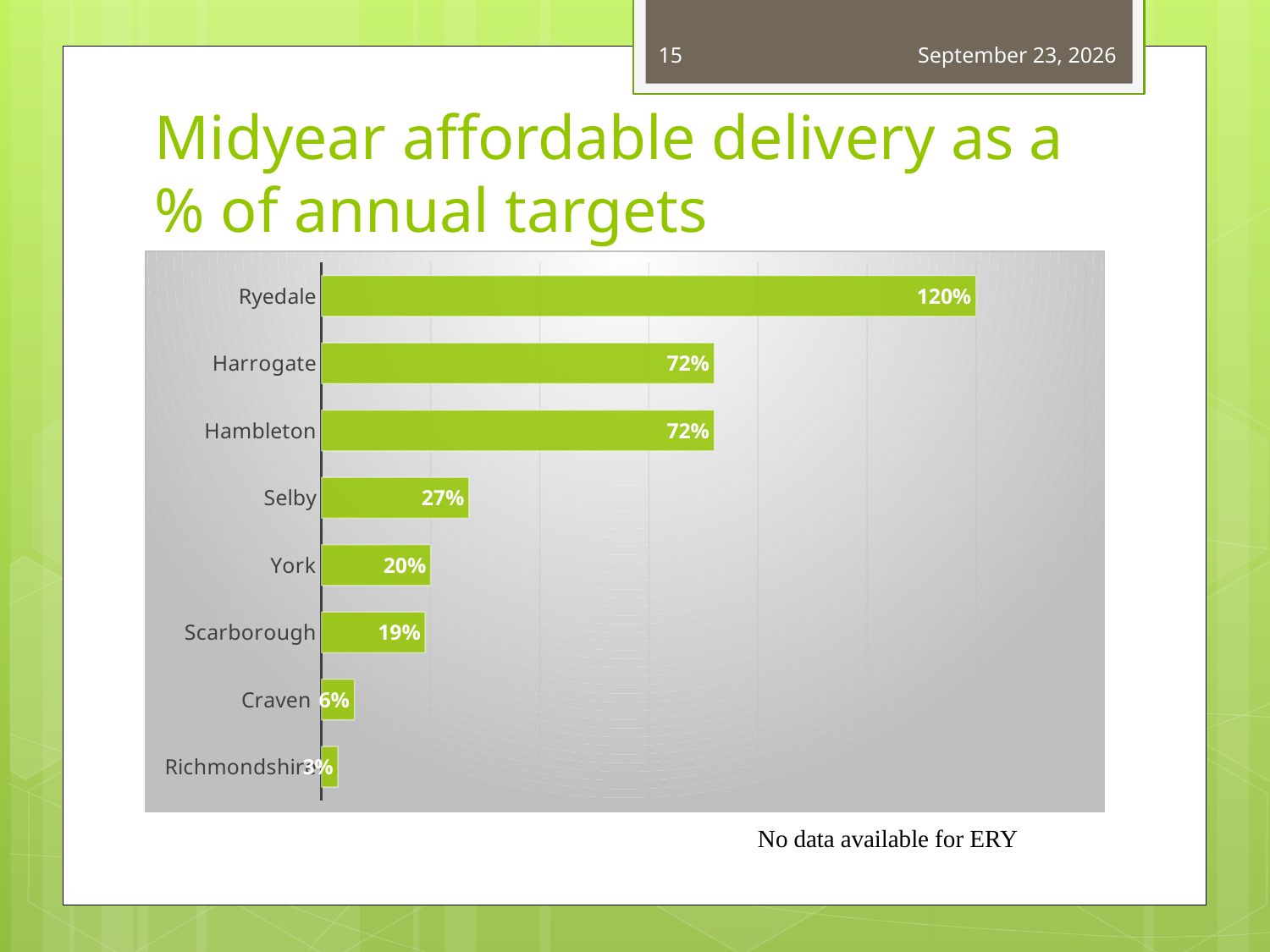
What is the value for Craven? 6% What is the value for Scarborough? 19% What is the value for Ryedale? 120% Which category has the lowest value? Richmondshire Which is larger, the value for Selby or the value for York? Selby Which category has the highest value? Ryedale What kind of chart is shown on the slide? Bar chart What is the value for Selby? 27% What is the difference between the values for Ryedale and Harrogate? 48% What is the title of the slide containing the chart? Midyear affordable delivery as a % of annual targets How many categories are shown in the chart? 8 What is the difference between the values for York and Scarborough? 1%